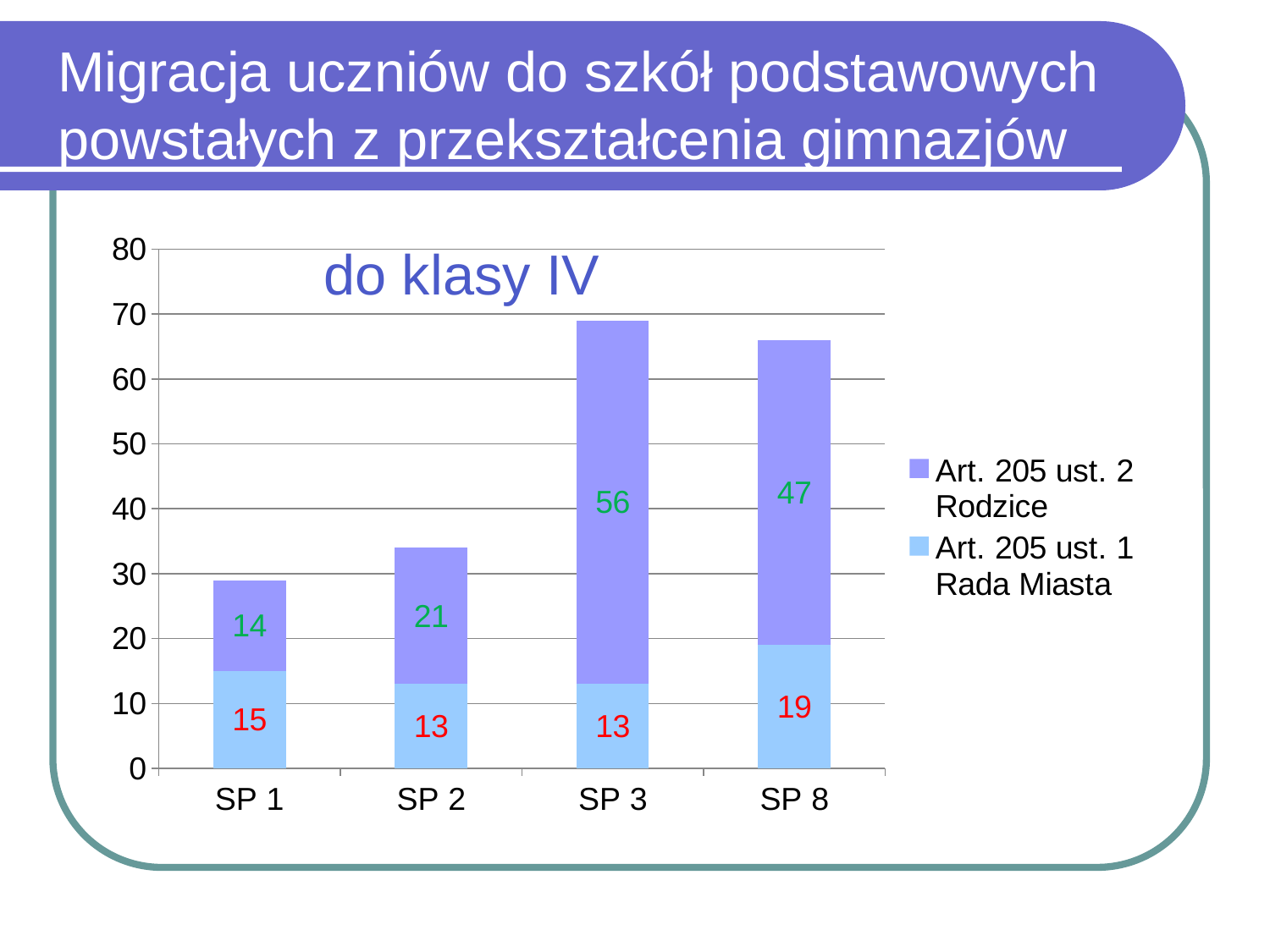
How many categories are shown on the x axis? 4 Which category has the lowest value for 'Art. 205 ust. 2 Rodzice'? SP 1 Which category has the highest value for 'Art. 205 ust. 2 Rodzice'? SP 3 What is the value for 'Art. 205 ust. 1 Rada Miasta' at SP 8? 19 What is the value for 'Art. 205 ust. 2 Rodzice' at SP 3? 56 How many series does the legend list? 2 What is the difference between the 'Art. 205 ust. 2 Rodzice' values for SP 3 and SP 8? 9 What kind of chart is shown on the slide? stacked bar chart What is the total of the stacked bar for SP 8? 66 Which is larger: the 'Art. 205 ust. 1 Rada Miasta' value for SP 1 or for SP 2? SP 1 Is the total stacked bar for SP 3 greater or less than 60? greater What is the total of the stacked bar for SP 1? 29